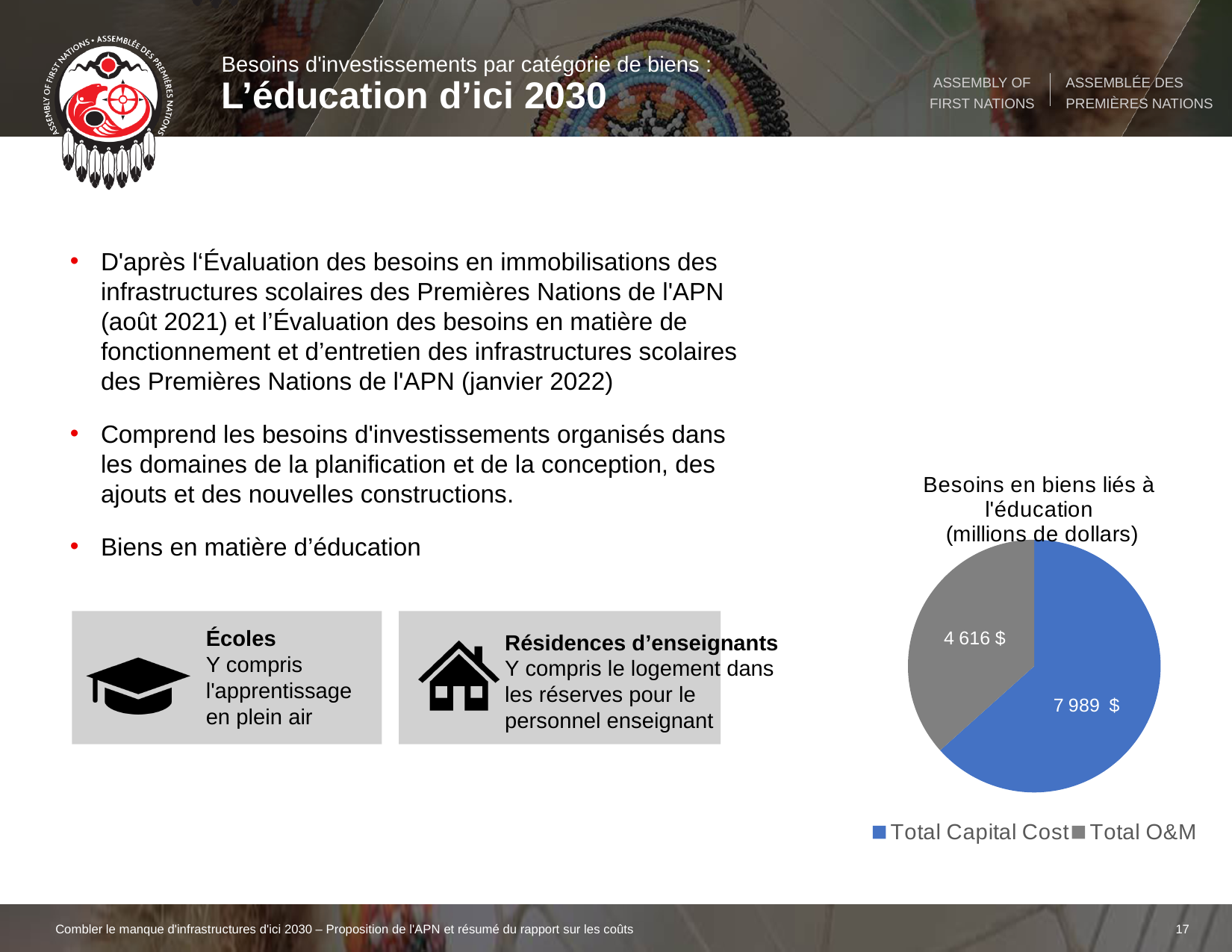
How many series does the legend list? 2 What is the value for Total Capital Cost in the pie chart? 7 989 $ What is the title of the chart? Besoins en biens liés à l'éducation (millions de dollars) What kind of chart is shown on the slide? pie chart Which slice of the pie chart is the largest? Total Capital Cost What is the value for Total O&M in the pie chart? 4 616 $ Which is larger, Total Capital Cost or Total O&M? Total Capital Cost What is the difference between Total Capital Cost and Total O&M? 3 373 $ What colour is the Total O&M slice? grey Which slice of the pie chart is the smallest? Total O&M What is the combined total of the two slices in the pie chart? 12 605 $